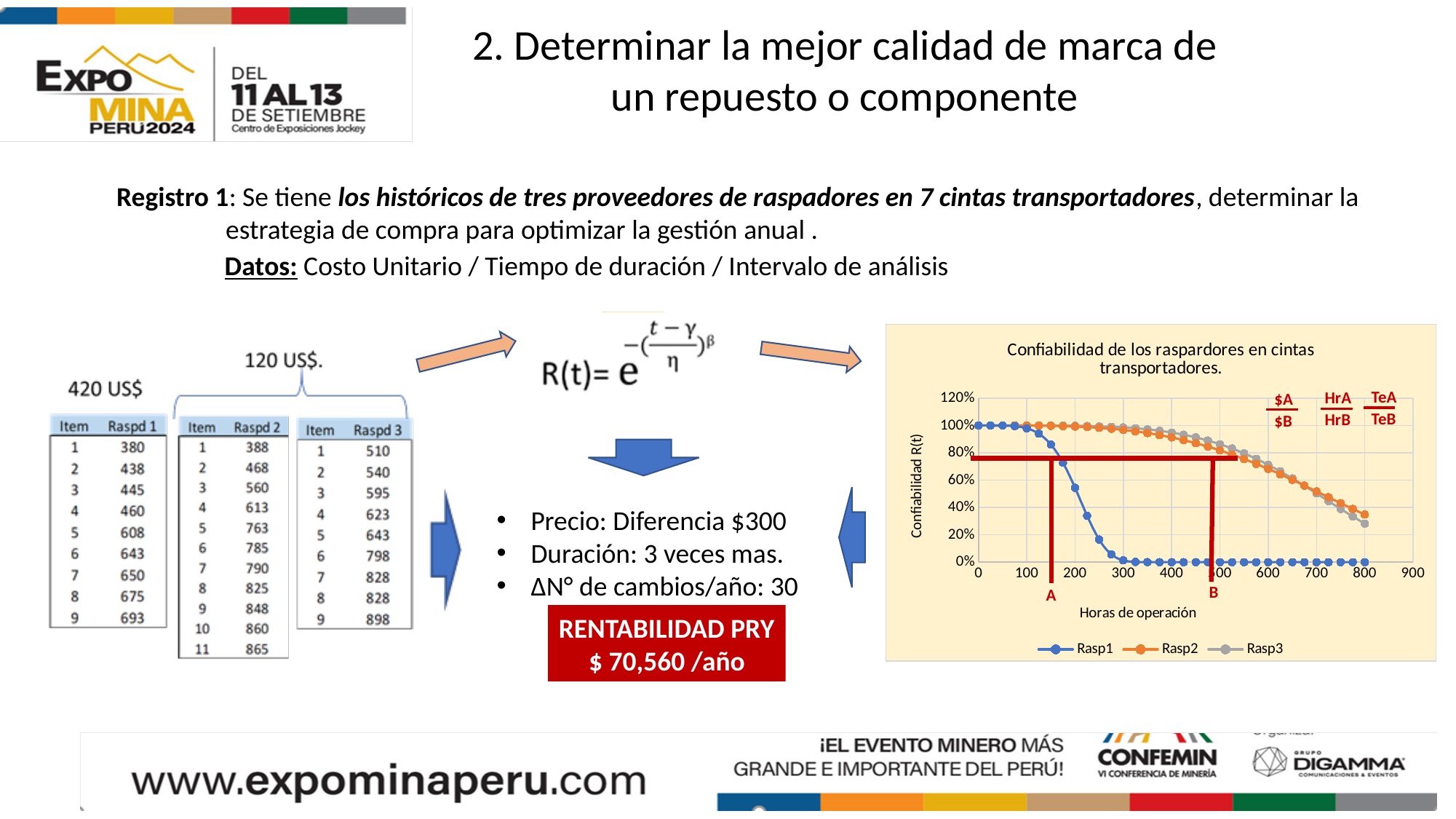
Is the value for Rasp2 at 600 hours of operation greater or less than 60%? greater What is the title of the chart? Confiabilidad de los raspardores en cintas transportadores. How many series does the chart legend list? 3 Is the value for Rasp3 at 400 hours of operation greater or less than 80%? greater Is the value for Rasp2 at 800 hours of operation greater or less than 20%? greater Does the reliability of Rasp1 rise or fall as the hours of operation increase? fall What kind of chart is shown on the slide? line chart At 300 hours of operation, which series has the larger value, Rasp1 or Rasp2? Rasp2 Which series has the lowest value at 500 hours of operation? Rasp1 What is the label of the x axis of the chart? Horas de operación